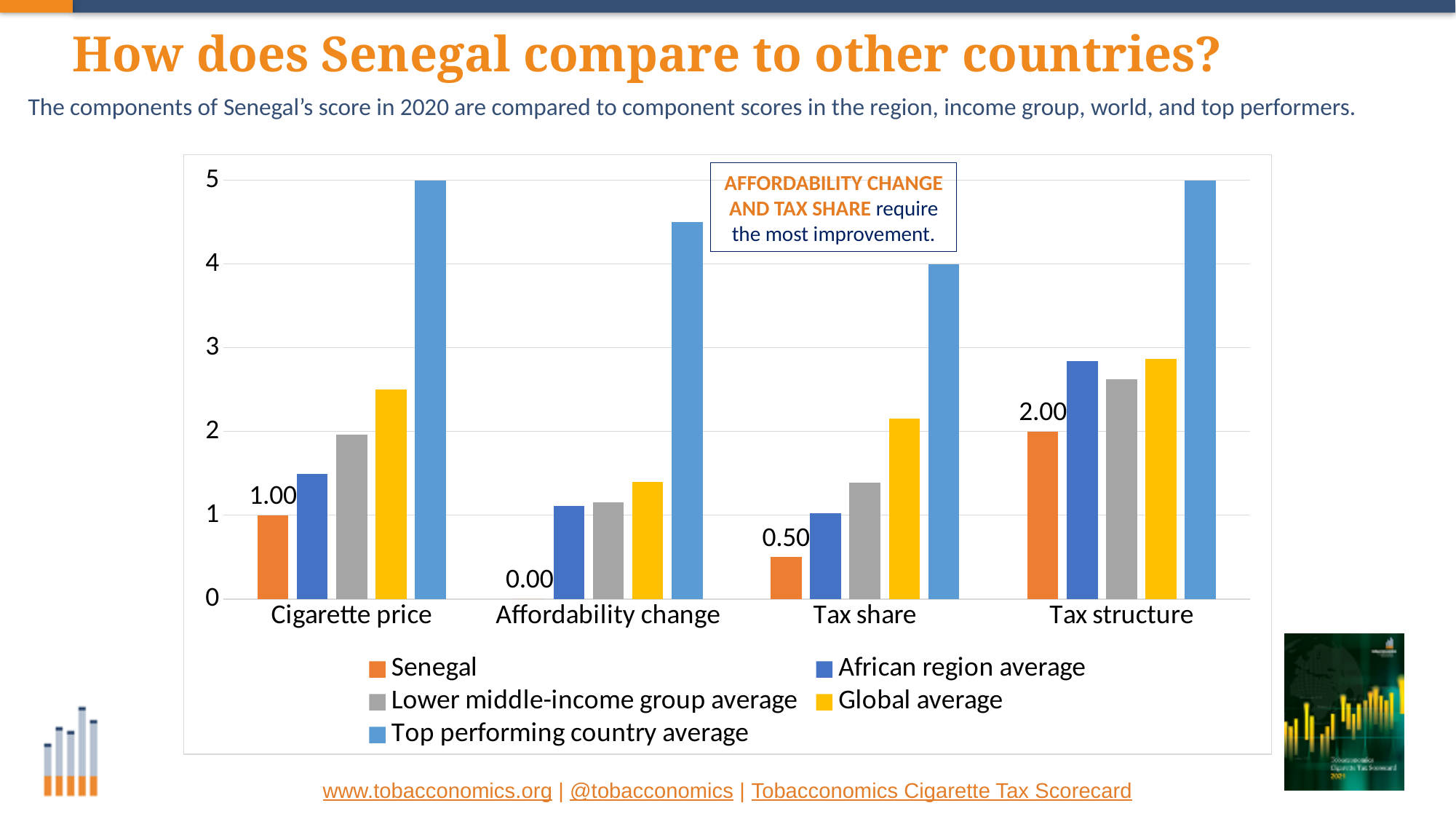
In which component does Senegal have its lowest score? Affordability change What type of chart is shown on the slide? Bar chart What is Senegal's score for Tax share? 0.50 Is the Global average for Tax share greater or less than 2? greater Is the Top performing country average for Affordability change greater or less than 4? greater What is Senegal's score for Tax structure? 2.00 Which is larger for Tax structure: the African region average or Senegal's score? African region average How many series does the legend list? 5 In which component does Senegal have its highest score? Tax structure What is the difference between Senegal's Tax structure score and its Cigarette price score? 1.00 What is Senegal's score for Cigarette price? 1.00 What is Senegal's score for Affordability change? 0.00